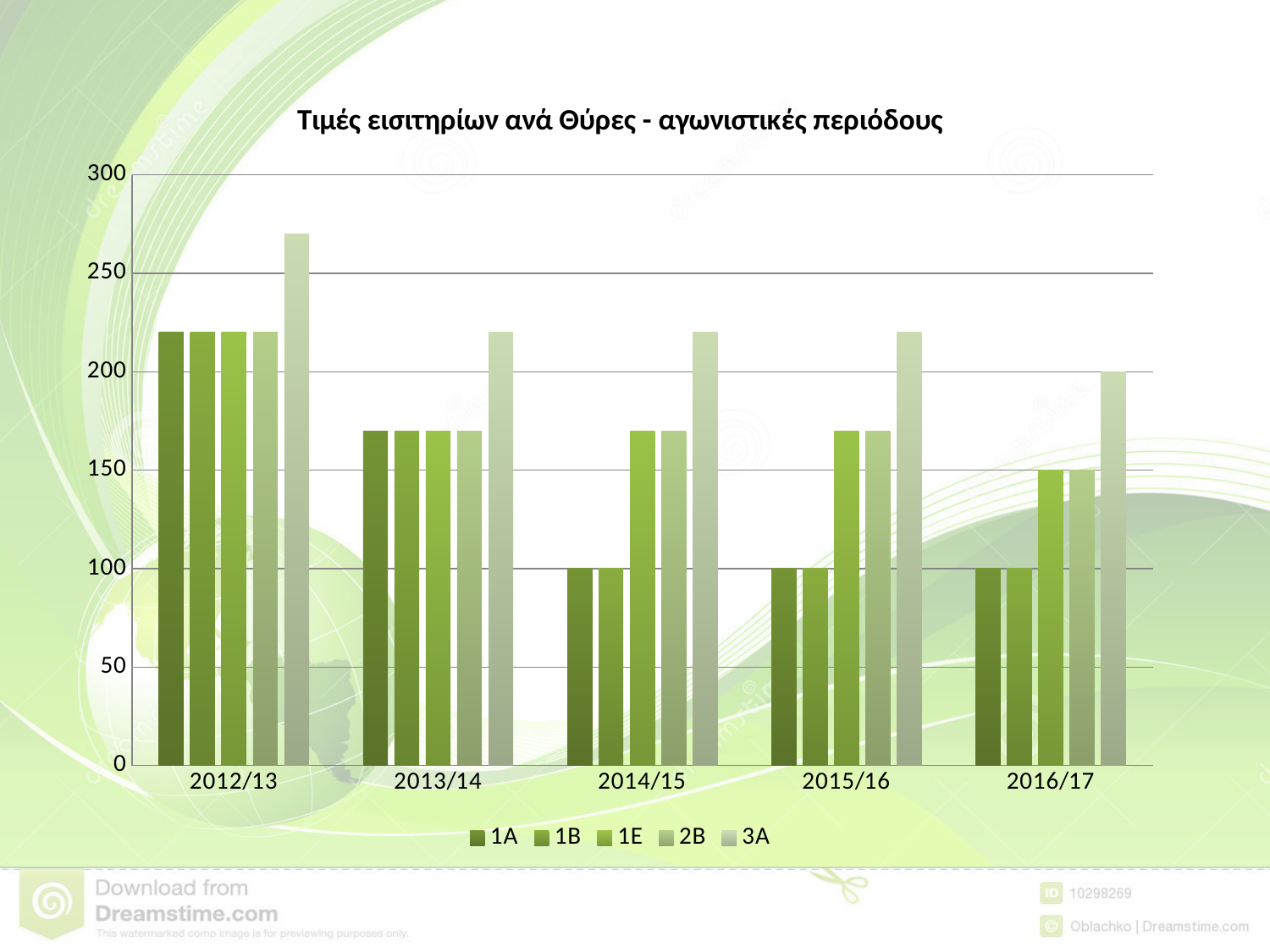
What is the value for series 1A in 2016/17? 100 How many series does the legend list? 5 How many seasons (categories) are shown on the x axis? 5 What is the value for series 3A in 2016/17? 200 Is the value for series 1A in 2013/14 greater or less than 200? less What is the value for series 1B in 2014/15? 100 Which season has the highest bar for series 3A? 2012/13 Does the value for series 1A rise or fall from 2012/13 to 2016/17? fall What kind of chart is shown on the slide? bar chart What is the value for series 1E in 2016/17? 150 Which is larger in 2015/16: the value for series 1A or the value for series 1E? 1E Is the value for series 3A in 2012/13 greater or less than 250? greater